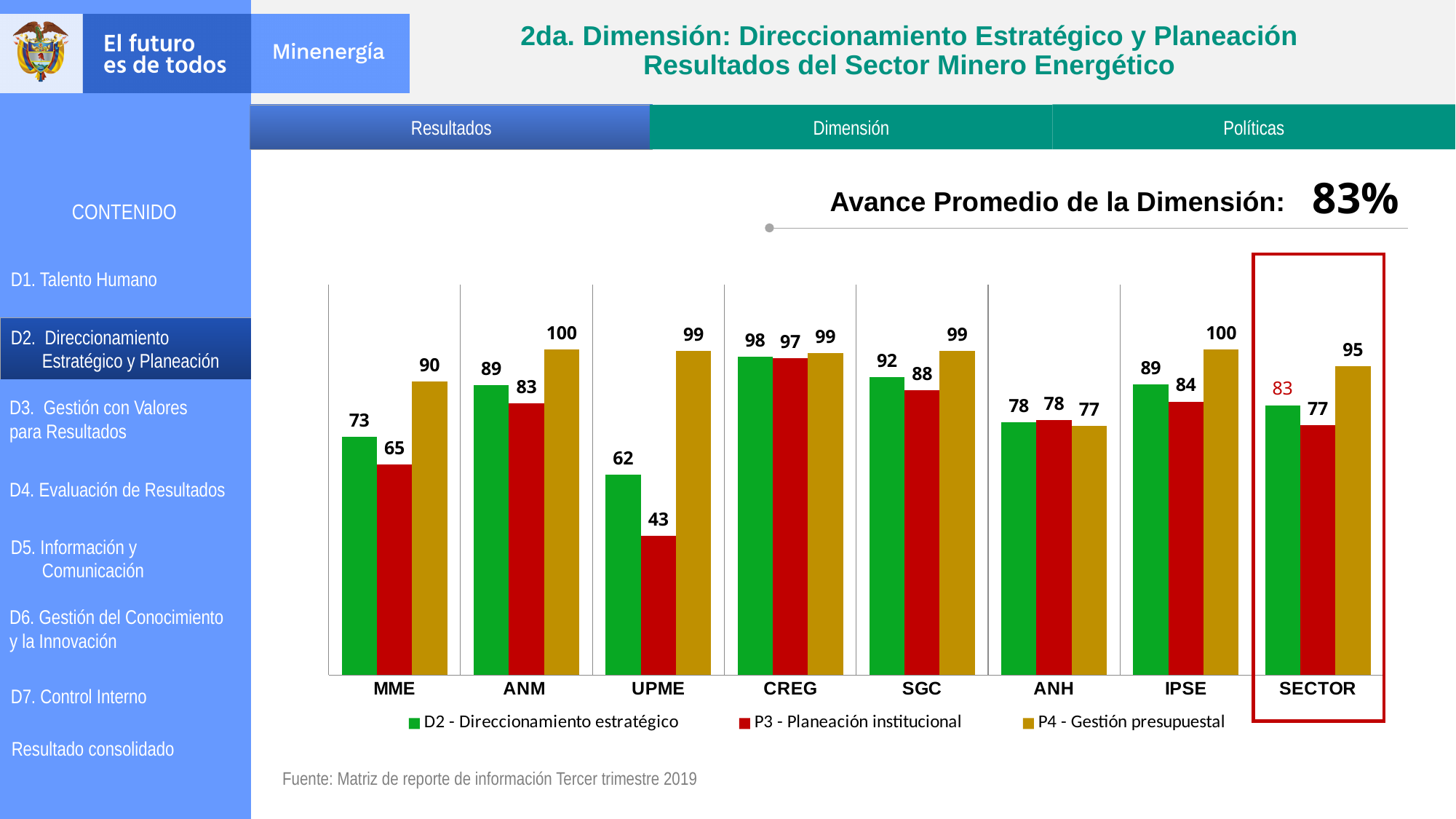
How many categories are shown on the x axis? 8 How many series does the legend list? 3 Which category on the x axis is highlighted with a red box? SECTOR What is the difference between the P4 - Gestión presupuestal and P3 - Planeación institucional values for UPME? 56 Which is larger for ANM: D2 - Direccionamiento estratégico or P3 - Planeación institucional? D2 - Direccionamiento estratégico Which category has the highest value for D2 - Direccionamiento estratégico? CREG What is the value of P3 - Planeación institucional for UPME? 43 What is the value of P4 - Gestión presupuestal for MME? 90 What is the Avance Promedio de la Dimensión shown above the chart? 83% Which category has the lowest value for P3 - Planeación institucional? UPME What kind of chart is shown on the slide? Bar chart What is the value of D2 - Direccionamiento estratégico for SECTOR? 83